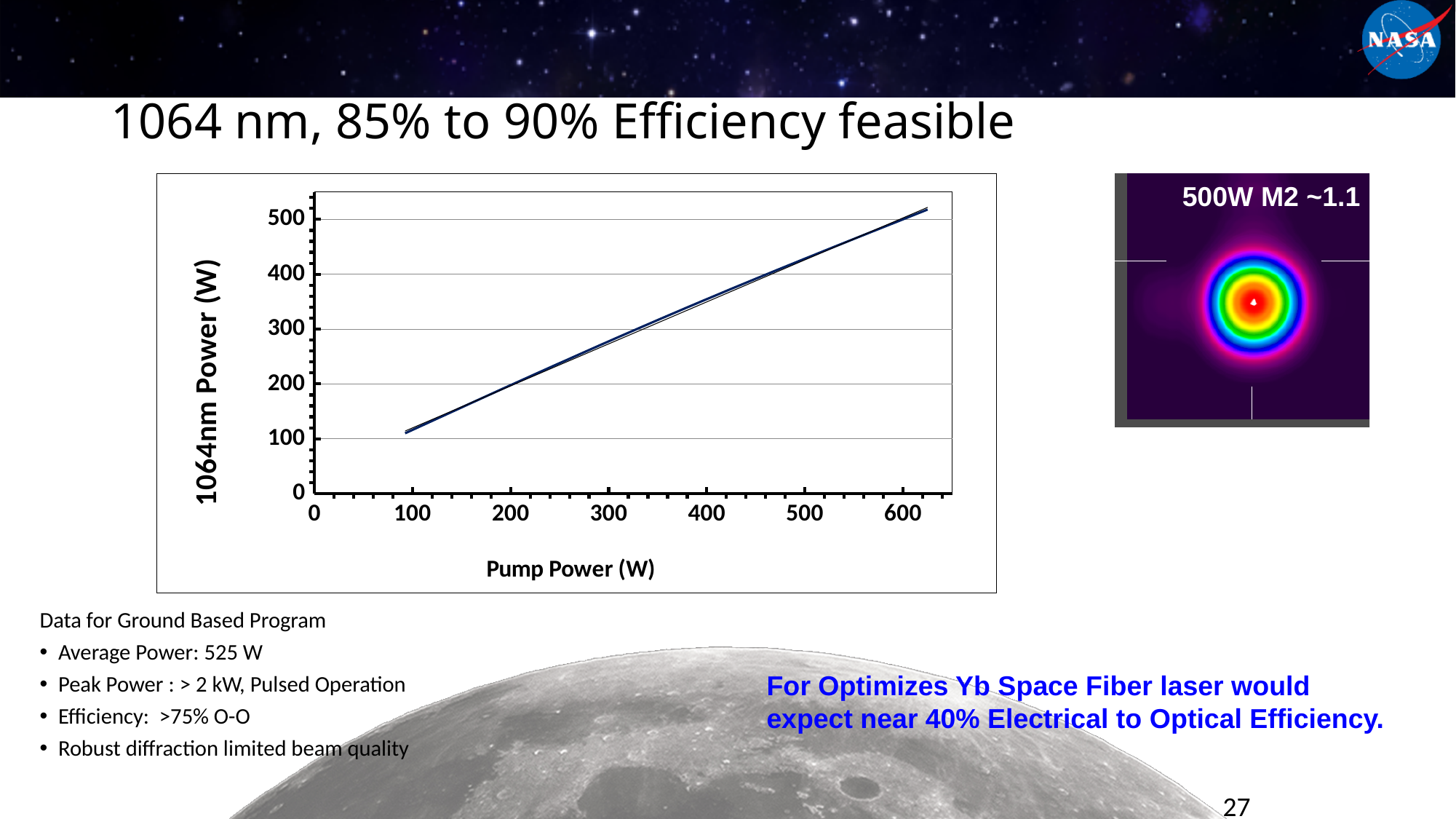
Is the 1064nm Power at a Pump Power of 600 W greater or less than 400? greater What is the highest tick value shown on the x axis of the chart? 600 Is the 1064nm Power at a Pump Power of 200 W greater or less than 300? less What is the label of the x axis of the chart? Pump Power (W) What kind of chart is shown on the slide? line chart Is the 1064nm Power at a Pump Power of 300 W greater or less than 200? greater What is the label of the y axis of the chart? 1064nm Power (W) Does the 1064nm Power rise or fall as Pump Power increases along the x axis? rise